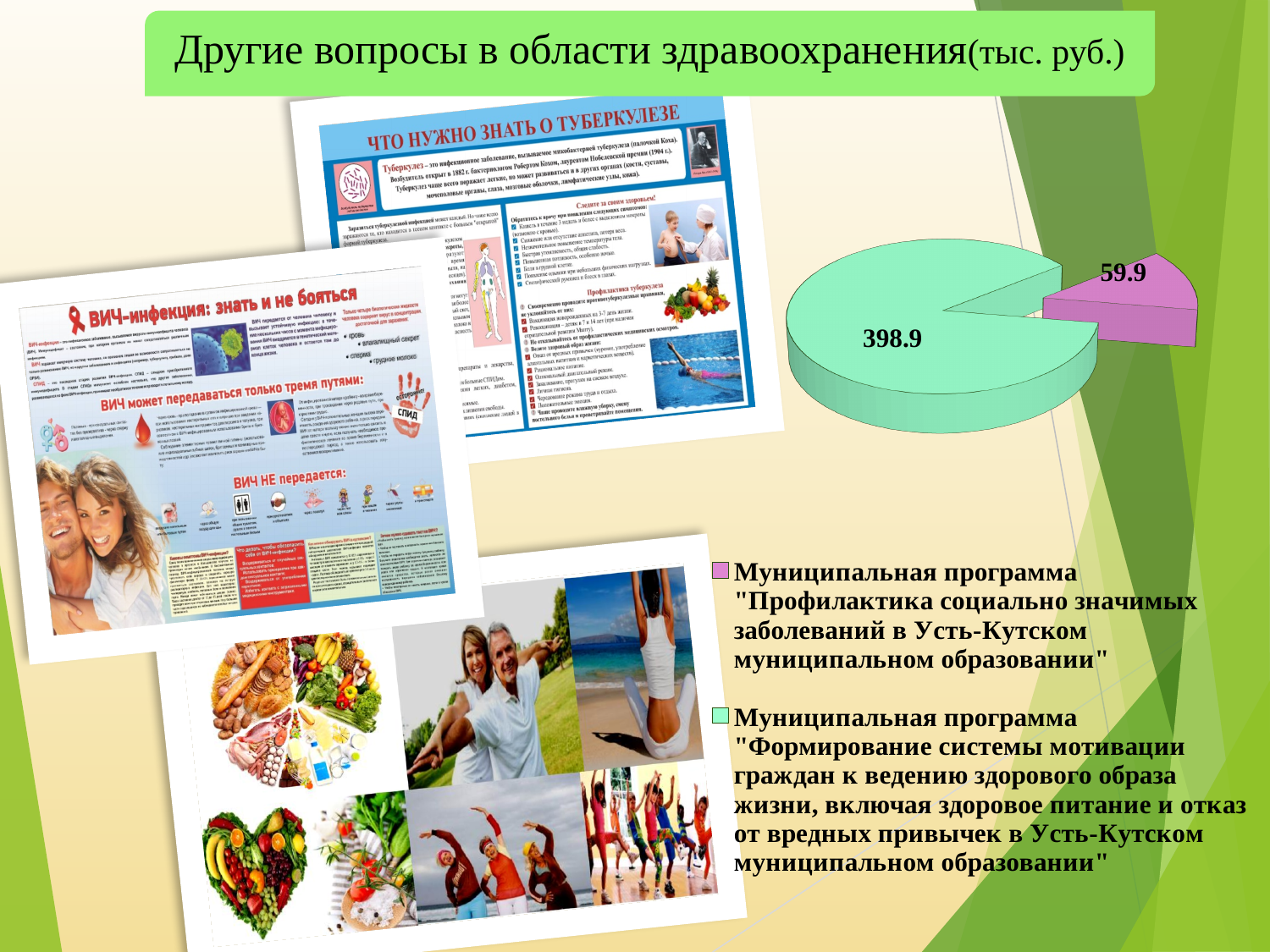
What is the value for the municipal programme "Формирование системы мотивации граждан к ведению здорового образа жизни..."? 398.9 What is the total of the two values shown in the pie chart? 458.8 What kind of chart is shown on the slide? pie chart How many slices does the pie chart have? 2 How many entries does the legend list? 2 What is the value for the municipal programme "Профилактика социально значимых заболеваний в Усть-Кутском муниципальном образовании"? 59.9 What is the title of the slide containing the chart? Другие вопросы в области здравоохранения(тыс. руб.) Which programme has the smallest slice of the pie? Муниципальная программа "Профилактика социально значимых заболеваний в Усть-Кутском муниципальном образовании" Which is larger: the value for the "Профилактика социально значимых заболеваний" programme or the value for the "Формирование системы мотивации граждан" programme? Формирование системы мотивации граждан What colour is the slice for the "Профилактика социально значимых заболеваний" programme? pink Which programme has the largest slice of the pie? Муниципальная программа "Формирование системы мотивации граждан к ведению здорового образа жизни, включая здоровое питание и отказ от вредных привычек в Усть-Кутском муниципальном образовании" What is the difference between the two values shown in the pie chart? 339.0